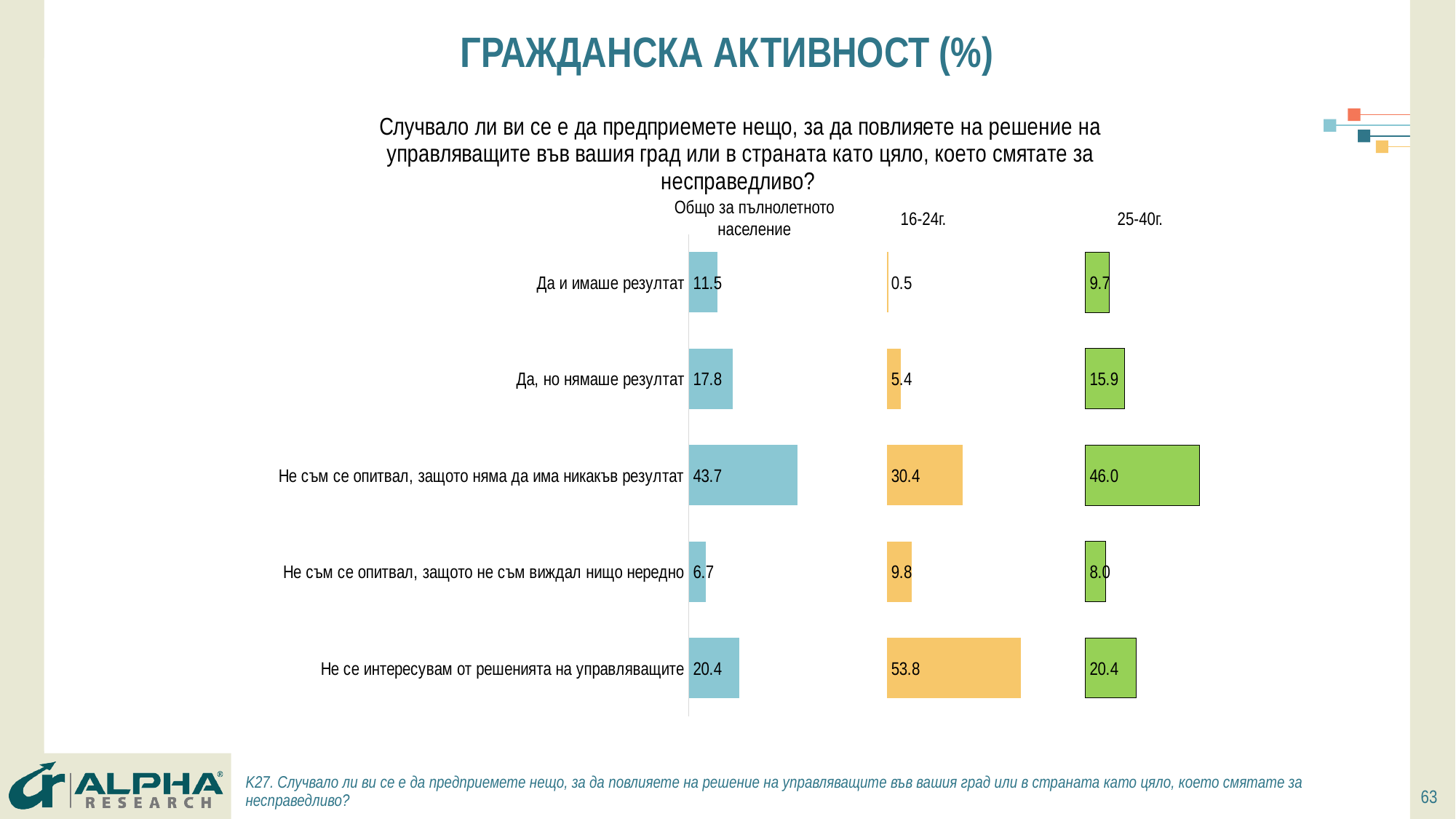
In the chart headed "Общо за пълнолетното население", what is the value for "Не съм се опитвал, защото няма да има никакъв резултат"? 43.7 In the chart headed "25-40г.", which category has the highest value? Не съм се опитвал, защото няма да има никакъв резултат What colour are the bars in the chart headed "16-24г."? Yellow/orange What is the difference between the "Не се интересувам от решенията на управляващите" values in the "16-24г." chart and the "25-40г." chart? 33.4 In the chart headed "Общо за пълнолетното население", what is the difference between "Да, но нямаше резултат" and "Да и имаше резултат"? 6.3 How many categories are shown in the chart headed "16-24г."? 5 What type of chart is used for the "25-40г." data? Bar chart In the chart headed "Общо за пълнолетното население", which category has the lowest value? Не съм се опитвал, защото не съм виждал нищо нередно In the chart headed "16-24г.", what is the value for "Не се интересувам от решенията на управляващите"? 53.8 Which is larger: the "Не съм се опитвал, защото не съм виждал нищо нередно" value in the "16-24г." chart or in the "25-40г." chart? 16-24г. In the chart headed "25-40г.", what is the value for "Да и имаше резултат"? 9.7 In the chart headed "16-24г.", which category has the lowest value? Да и имаше резултат